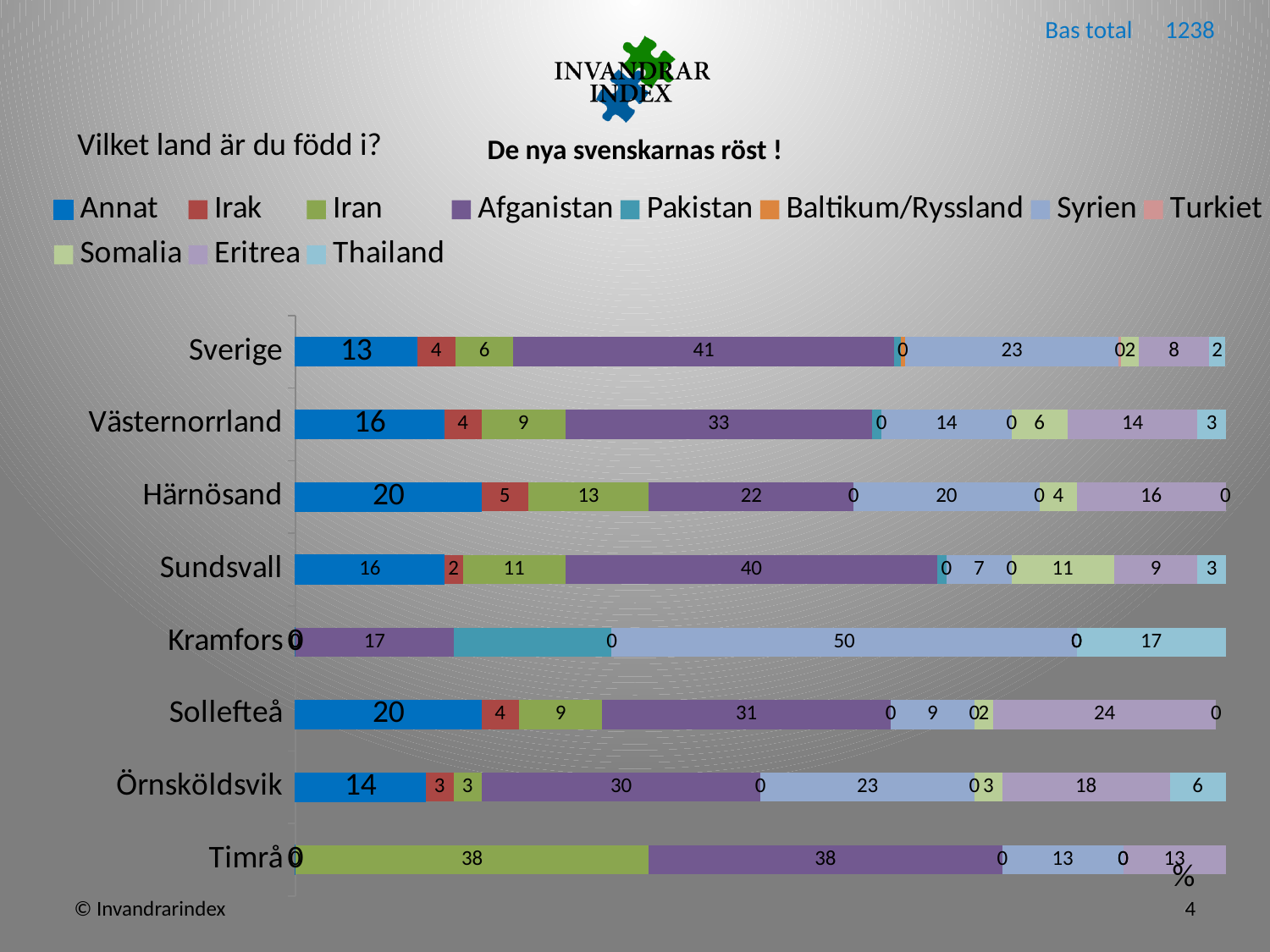
How many series does the legend list? 11 What is the value for Syrien in the Kramfors bar? 50 In the Härnösand bar, which is larger: the Iran value or the Irak value? Iran In the Sundsvall bar, what is the difference between the Afganistan value and the Annat value? 24 How many categories (regions) are shown on the chart? 8 What is the value for Eritrea in the Sollefteå bar? 24 In the Sverige bar, what is the difference between the Afganistan value and the Syrien value? 18 What kind of chart is shown on the slide? Stacked bar chart What is the value for Annat in the Härnösand bar? 20 What is the value for Thailand in the Örnsköldsvik bar? 6 What is the value for Iran in the Timrå bar? 38 What is the value for Afganistan in the Sverige bar? 41